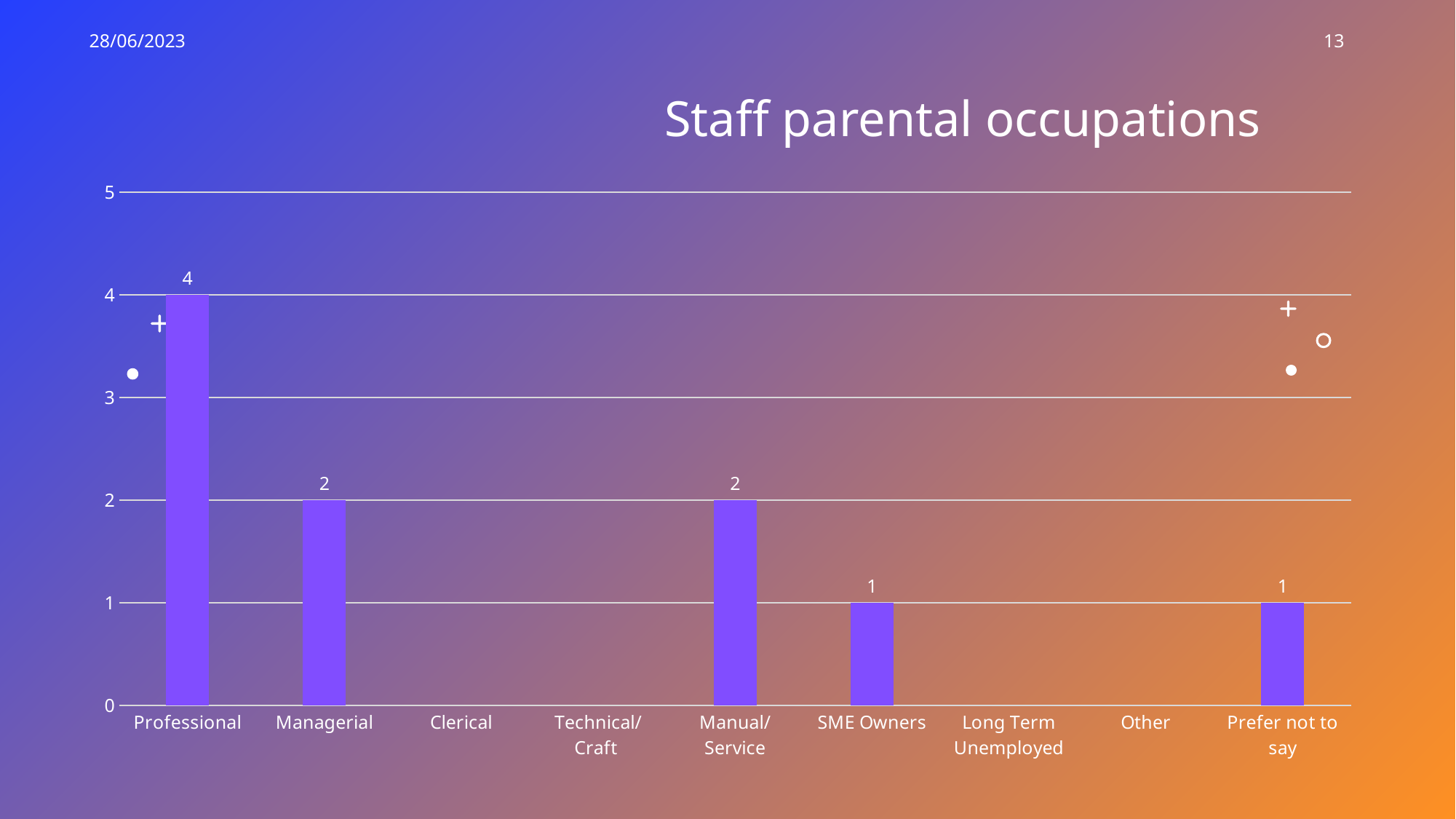
What is the value for SME Owners? 1 What is the title of the chart? Staff parental occupations What is the value for Professional? 4 Which is larger, the value for Manual/Service or the value for SME Owners? Manual/Service What kind of chart is shown on the slide? bar chart What is the difference between the values for Manual/Service and Prefer not to say? 1 Which category has the highest value? Professional What is the value for Managerial? 2 Is the value for Professional greater or less than 3? greater What is the difference between the values for Professional and Managerial? 2 How many categories are shown on the x axis? 9 What is the value for Prefer not to say? 1